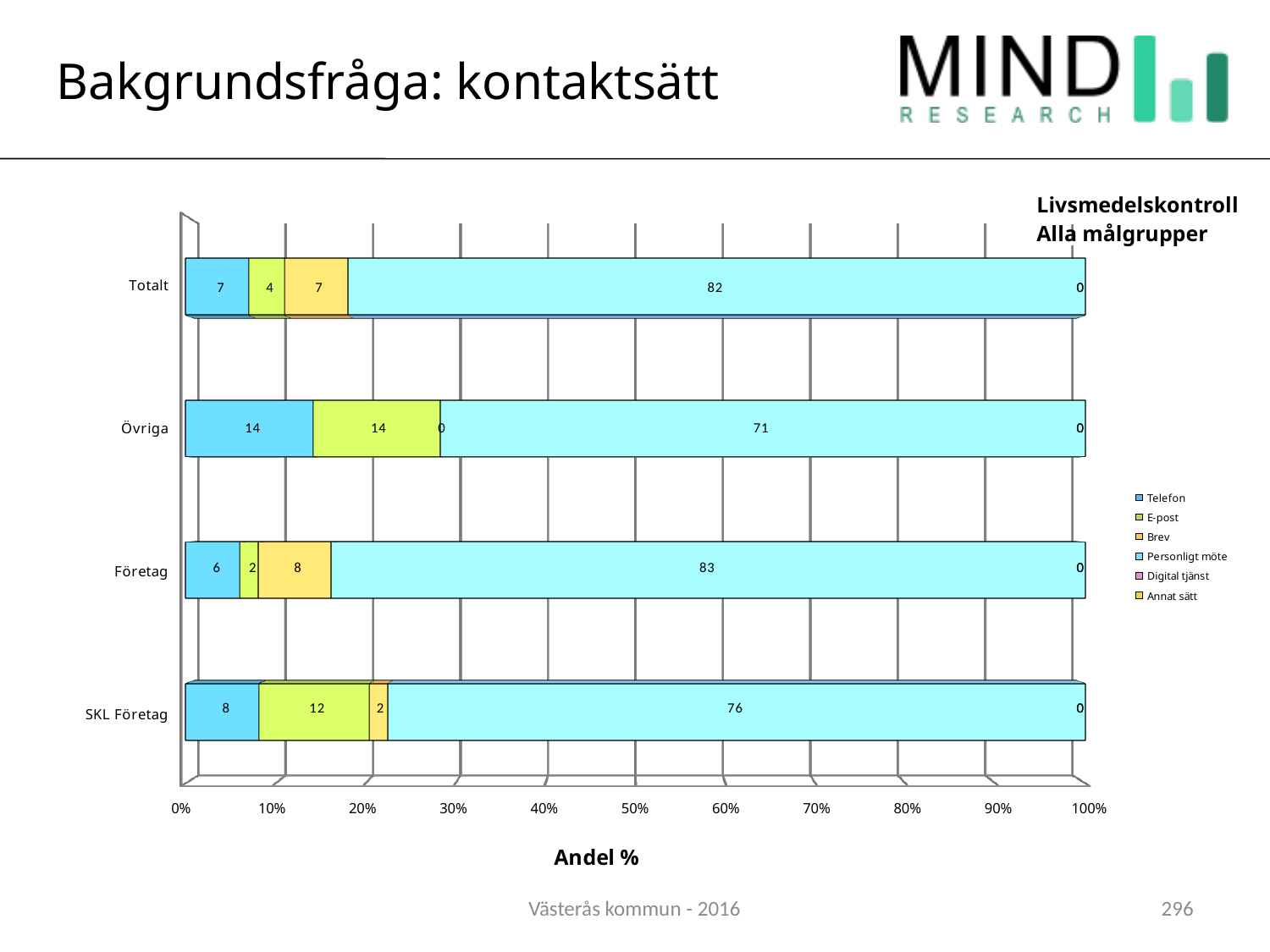
How many series does the legend list? 6 What is the value for Brev in the Företag bar? 8 Which category has the highest value for Personligt möte? Företag Which is larger, the Telefon value for Övriga or the Telefon value for Företag? Övriga Which category has the lowest value for Telefon? Företag What kind of chart is shown on the slide? Stacked bar chart What is the label of the horizontal axis? Andel % What is the difference between the Personligt möte values for Totalt and Övriga? 11 What is the value for Personligt möte in the Totalt bar? 82 How many categories are shown on the vertical axis? 4 What is the value for Telefon in the Övriga bar? 14 What is the value for E-post in the SKL Företag bar? 12